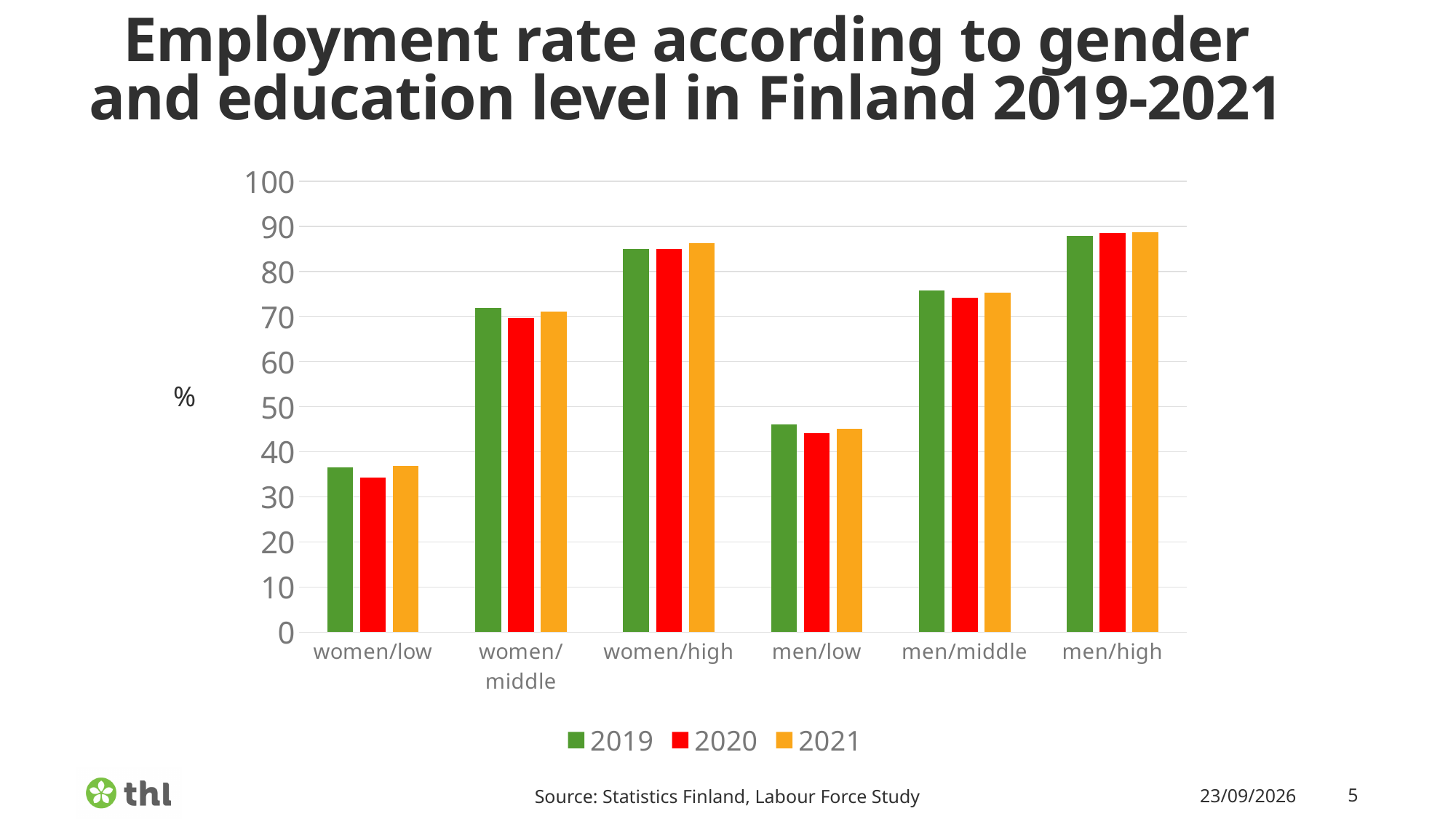
Is the 2021 value for women/high greater or less than 80? greater Is the 2020 value for men/low greater or less than 50? less What kind of chart is shown on the slide? bar chart Is the 2019 value for men/low greater or less than 40? greater Which colour represents the 2021 series in the legend? orange Which is larger for 2019: the value for women/middle or the value for men/middle? men/middle Which category has the highest employment rate for 2019? men/high How many categories are shown on the x axis? 6 Which category has the lowest employment rate for 2020? women/low How many series does the legend list? 3